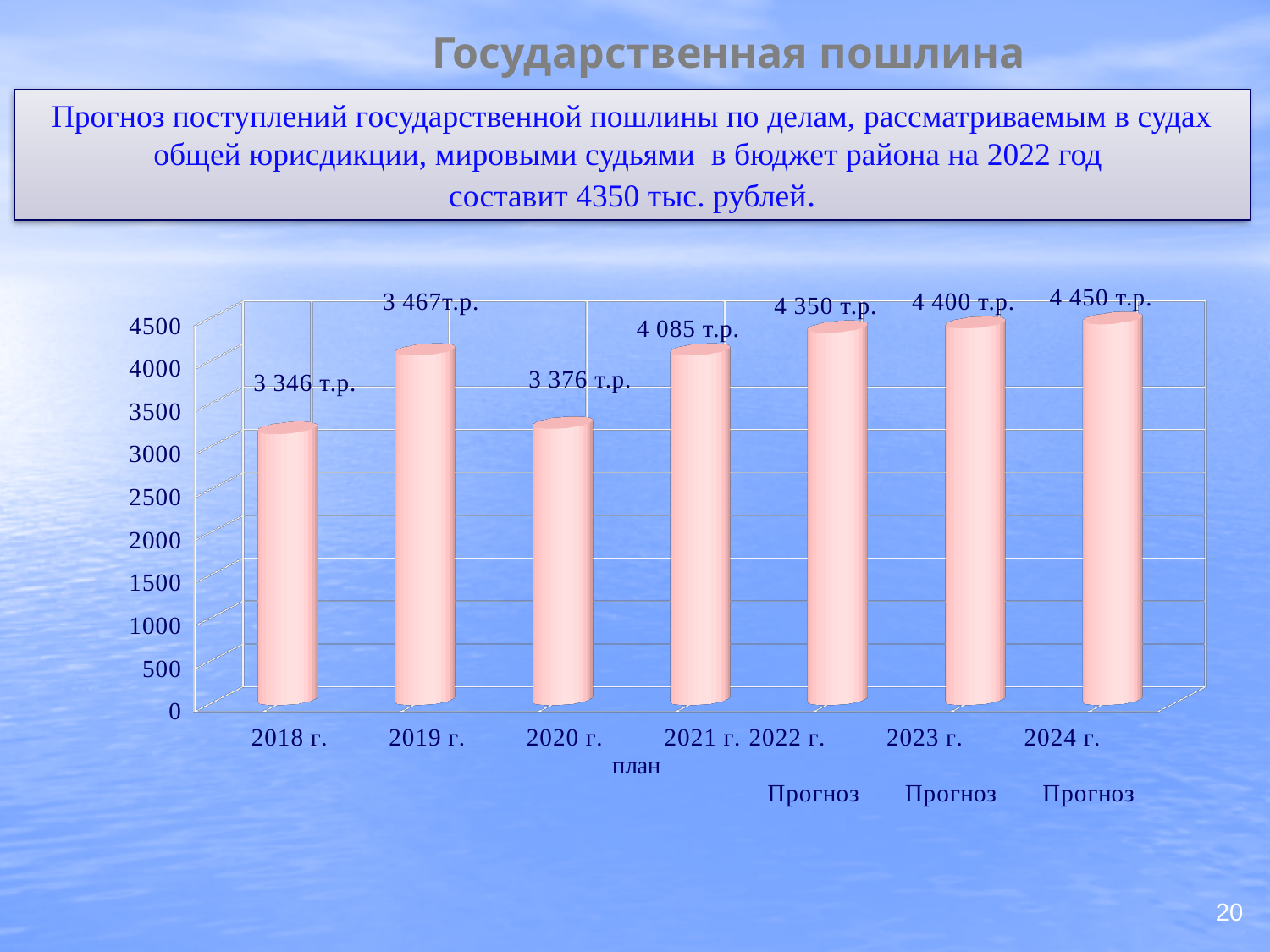
Is the value for 2020 г. greater or less than 3500? less What kind of chart is shown on the slide? bar chart What is the difference between the values for 2024 г. and 2018 г.? 1 104 т.р. Which is larger, the value for 2019 г. or the value for 2020 г.? 2019 г. What is the difference between the values for 2022 г. and 2021 г.? 265 т.р. Which year has the lowest value on the chart? 2018 г. What is the value shown for 2018 г.? 3 346 т.р. How many years are shown on the x axis of the chart? 7 What is the forecast value shown for 2024 г.? 4 450 т.р. What is the forecast value shown for 2022 г.? 4 350 т.р. Which year has the highest value on the chart? 2024 г. What is the value shown for 2021 г. план? 4 085 т.р.